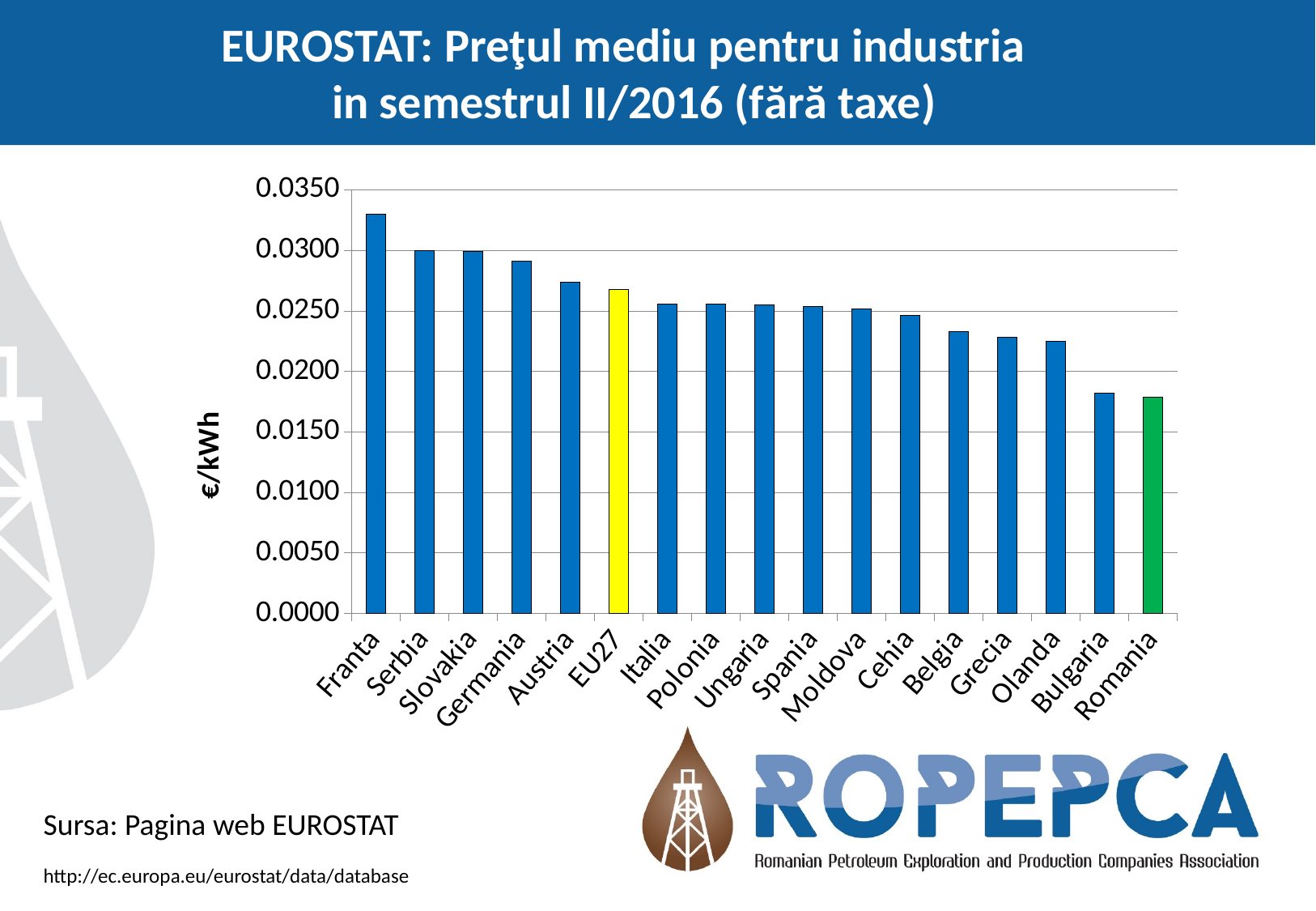
Is the value for Franta greater or less than 0.0300? greater Which category has the highest value? Franta How many countries/categories are plotted on the x axis? 17 Is the value for Romania greater or less than 0.0200? less Do the values rise or fall from left to right along the x axis? fall What colour is the bar for EU27? yellow What is the label on the y axis? €/kWh Which is larger, the value for Germania or the value for Olanda? Germania Is the value for Belgia greater or less than 0.0250? less What kind of chart is shown on the slide? bar chart